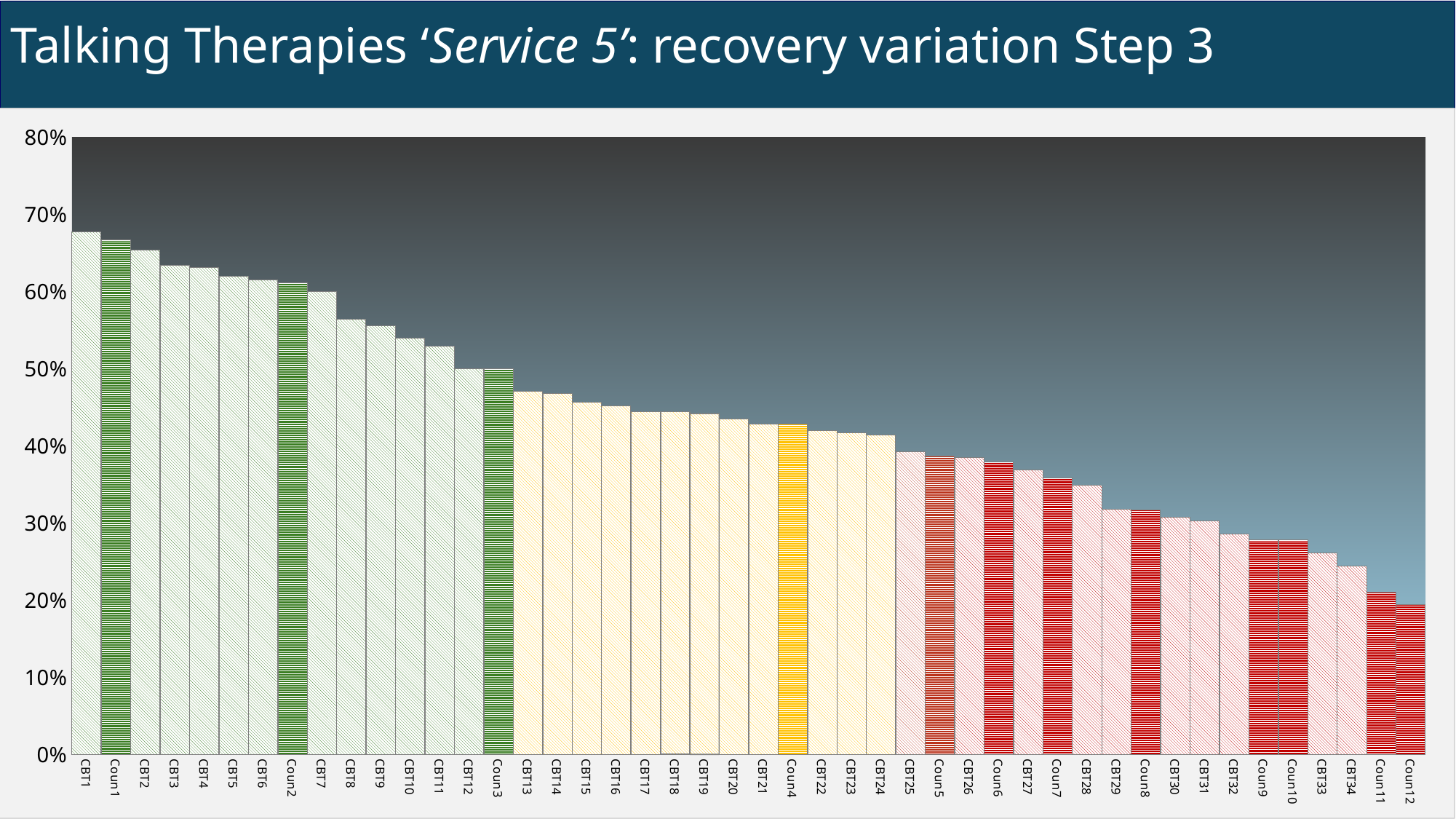
Which category has the highest value? CBT1 Do the values rise or fall moving from left to right along the x axis? fall What kind of chart is shown on the slide? bar chart Is the value for CBT13 greater or less than 50%? less How many categories (bars) are plotted on the chart? 46 Is the value for CBT28 greater or less than 40%? less Which has the larger value, Coun2 or Coun4? Coun2 What is the title of the slide? Talking Therapies 'Service 5': recovery variation Step 3 Is the value for CBT1 greater or less than 60%? greater Which category has the lowest value? Coun12 Which has the larger value, CBT13 or CBT25? CBT13